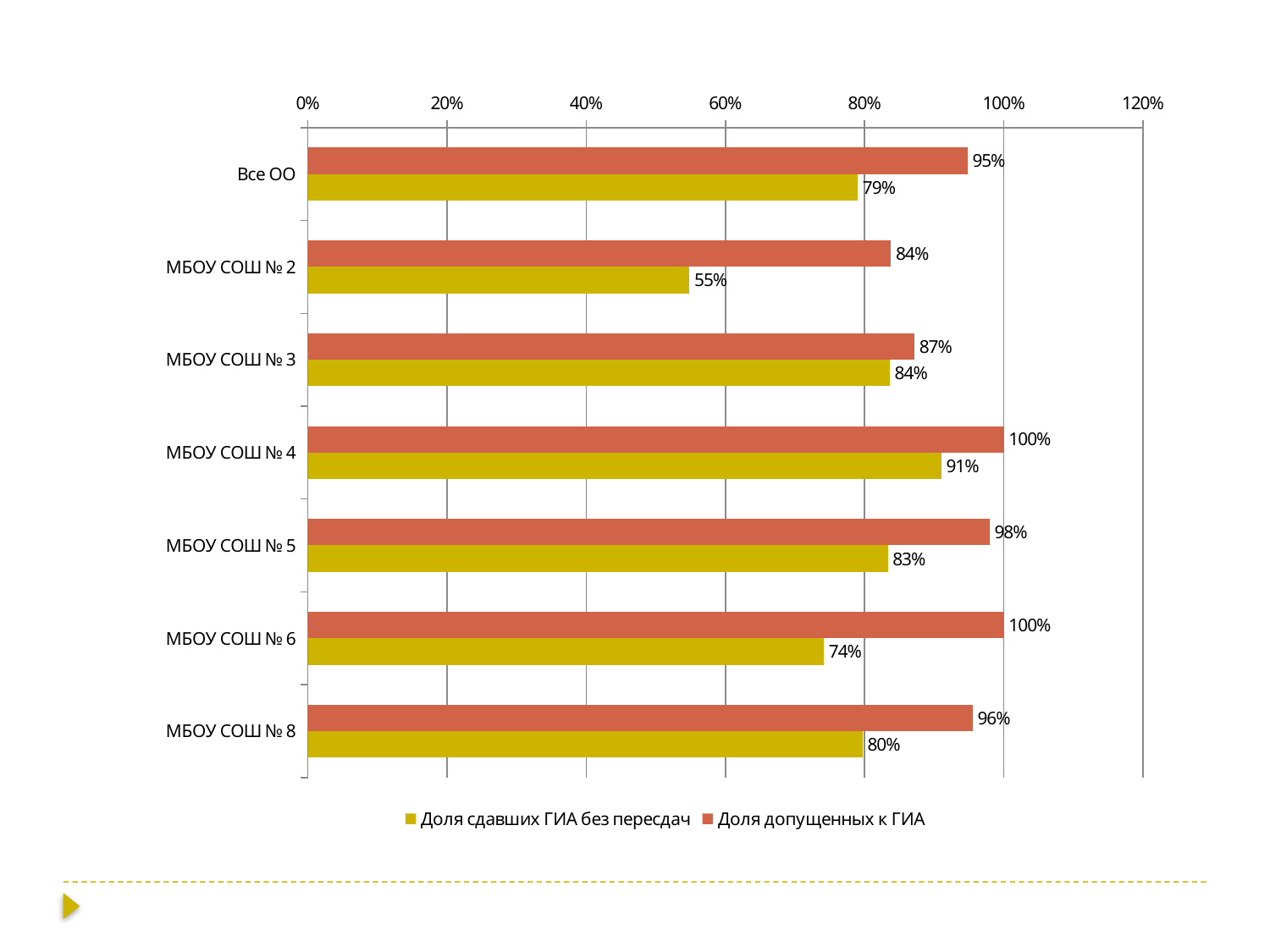
Which is larger for МБОУ СОШ № 3: "Доля допущенных к ГИА" or "Доля сдавших ГИА без пересдач"? Доля допущенных к ГИА What is the value of "Доля сдавших ГИА без пересдач" for МБОУ СОШ № 2? 55% How many series does the legend list? 2 Is the value of "Доля сдавших ГИА без пересдач" for МБОУ СОШ № 8 greater or less than 60%? greater Which category has the highest value for "Доля сдавших ГИА без пересдач"? МБОУ СОШ № 4 What kind of chart is shown on the slide? bar chart How many categories are shown on the chart? 7 Which category has the lowest value for "Доля сдавших ГИА без пересдач"? МБОУ СОШ № 2 What is the value of "Доля допущенных к ГИА" for МБОУ СОШ № 5? 98% What is the value of "Доля сдавших ГИА без пересдач" for Все ОО? 79% What is the difference between "Доля допущенных к ГИА" and "Доля сдавших ГИА без пересдач" for МБОУ СОШ № 6? 26% Which colour represents "Доля допущенных к ГИА" in the chart? red (orange-red)